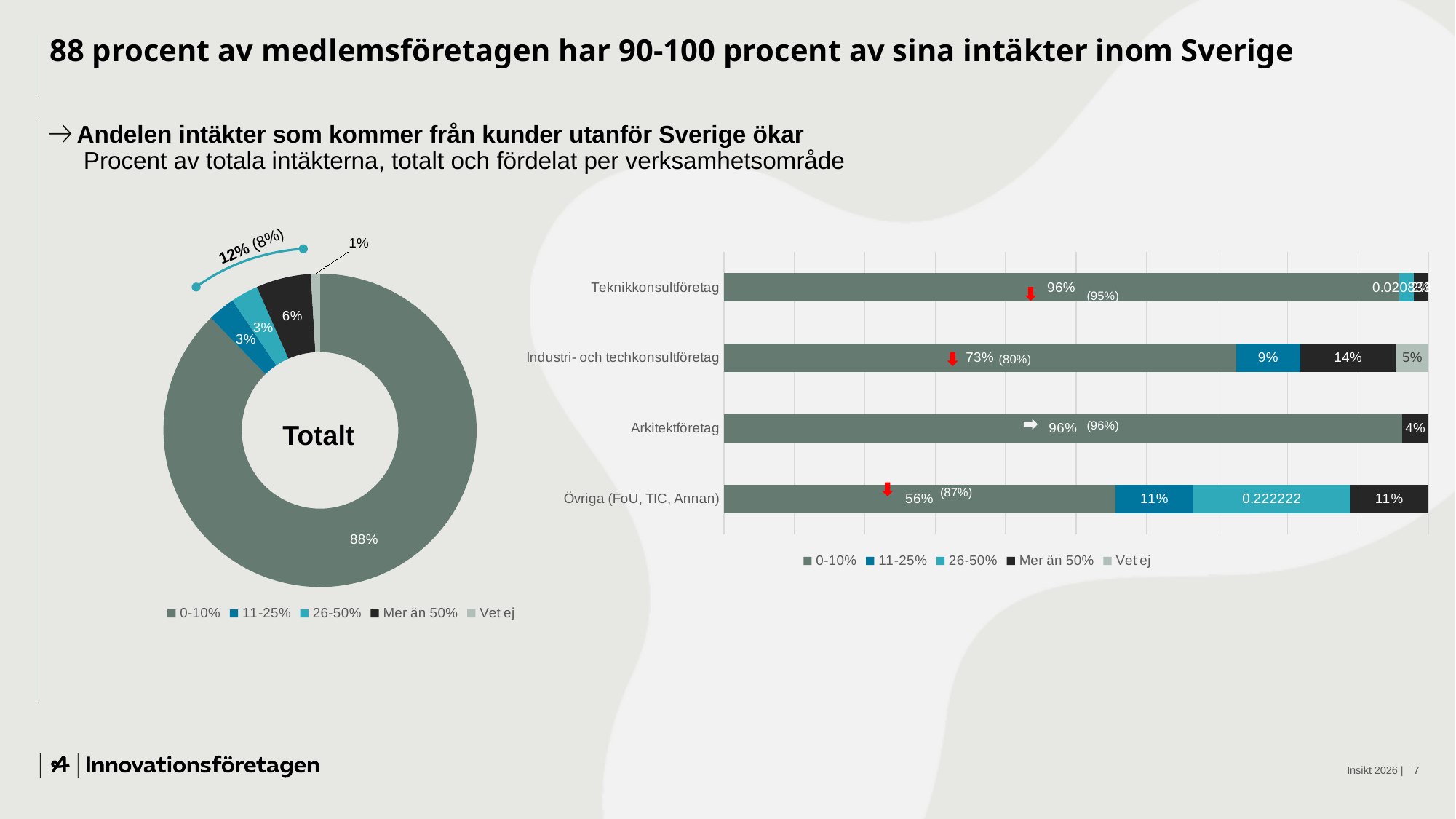
In the donut chart titled "Totalt", what share is shown for the 0-10% category? 88% In the stacked bar chart on the right, how many series does the legend list? 5 In the stacked bar chart on the right, what is the value of the "Mer än 50%" segment for Industri- och techkonsultföretag? 14% In the donut chart titled "Totalt", which category has the largest slice? 0-10% In the stacked bar chart on the right, what is the value of the 0-10% segment for Övriga (FoU, TIC, Annan)? 56% In the stacked bar chart on the right, how much larger is the "Mer än 50%" segment than the 11-25% segment for Industri- och techkonsultföretag? 5 percentage points In the donut chart titled "Totalt", which category has the smallest slice? Vet ej In the stacked bar chart on the right, how many business areas (categories) are shown? 4 In the stacked bar chart on the right, what is the value of the "Mer än 50%" segment for Arkitektföretag? 4% In the donut chart titled "Totalt", what share is shown for the "Mer än 50%" category? 6% In the stacked bar chart on the right, what is the value of the 11-25% segment for Industri- och techkonsultföretag? 9% In the stacked bar chart on the right, which business area has the lowest value for the 0-10% segment? Övriga (FoU, TIC, Annan)